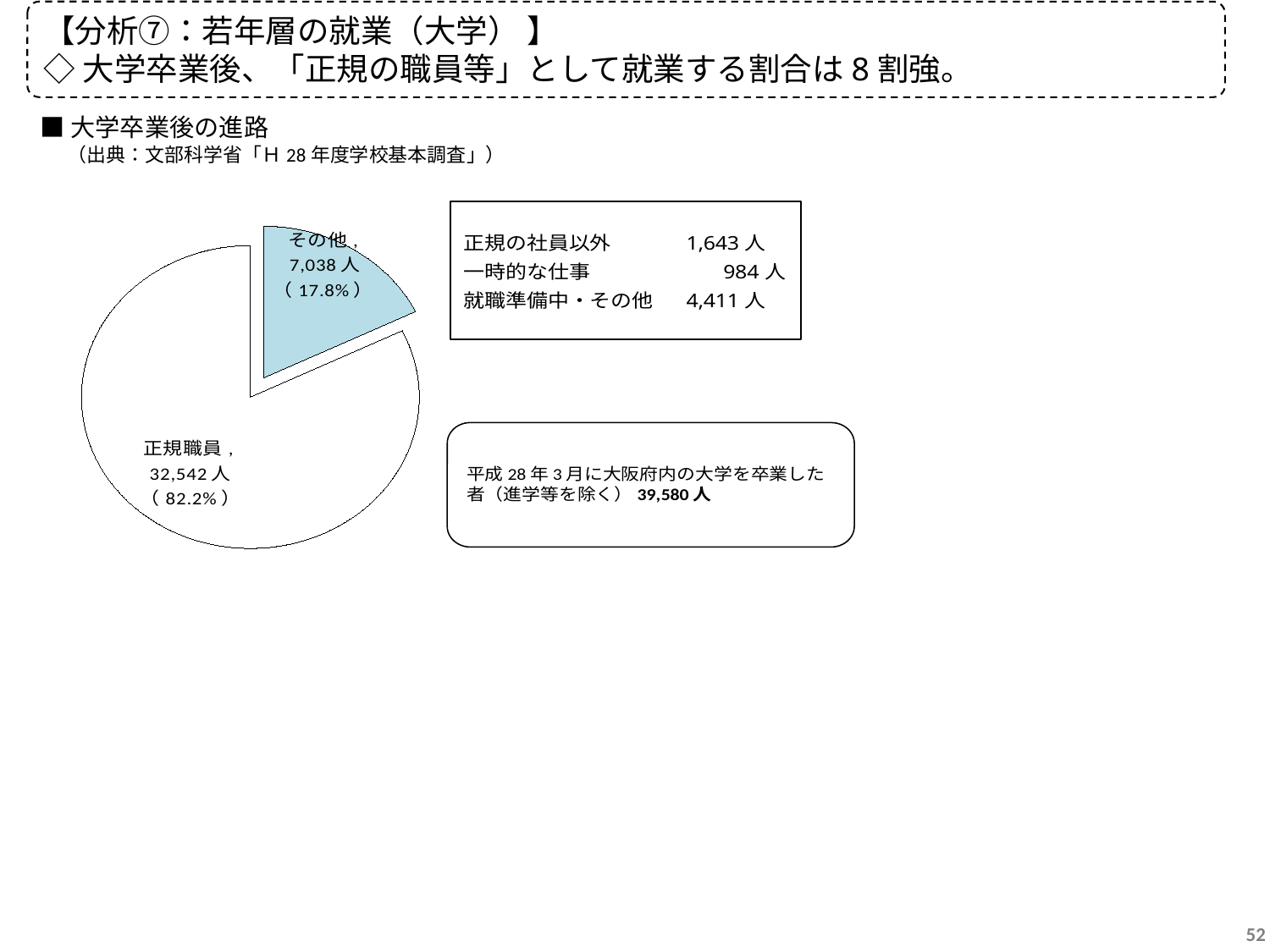
How many slices does the pie chart have? 2 Which slice of the pie chart is the largest? 正規職員 What share of the pie does その他 represent? 17.8% What is the value for その他 in the pie chart? 7,038人 What is the value for 正規職員 in the pie chart? 32,542人 What share of the pie does 正規職員 represent? 82.2% Which slice of the pie chart is shaded light blue? その他 What kind of chart is shown on the slide? pie chart What is the total number of people represented by the pie chart? 39,580人 Which slice of the pie chart is the smallest? その他 Which is larger, 正規職員 or その他? 正規職員 What is the difference in people between 正規職員 and その他? 25,504人